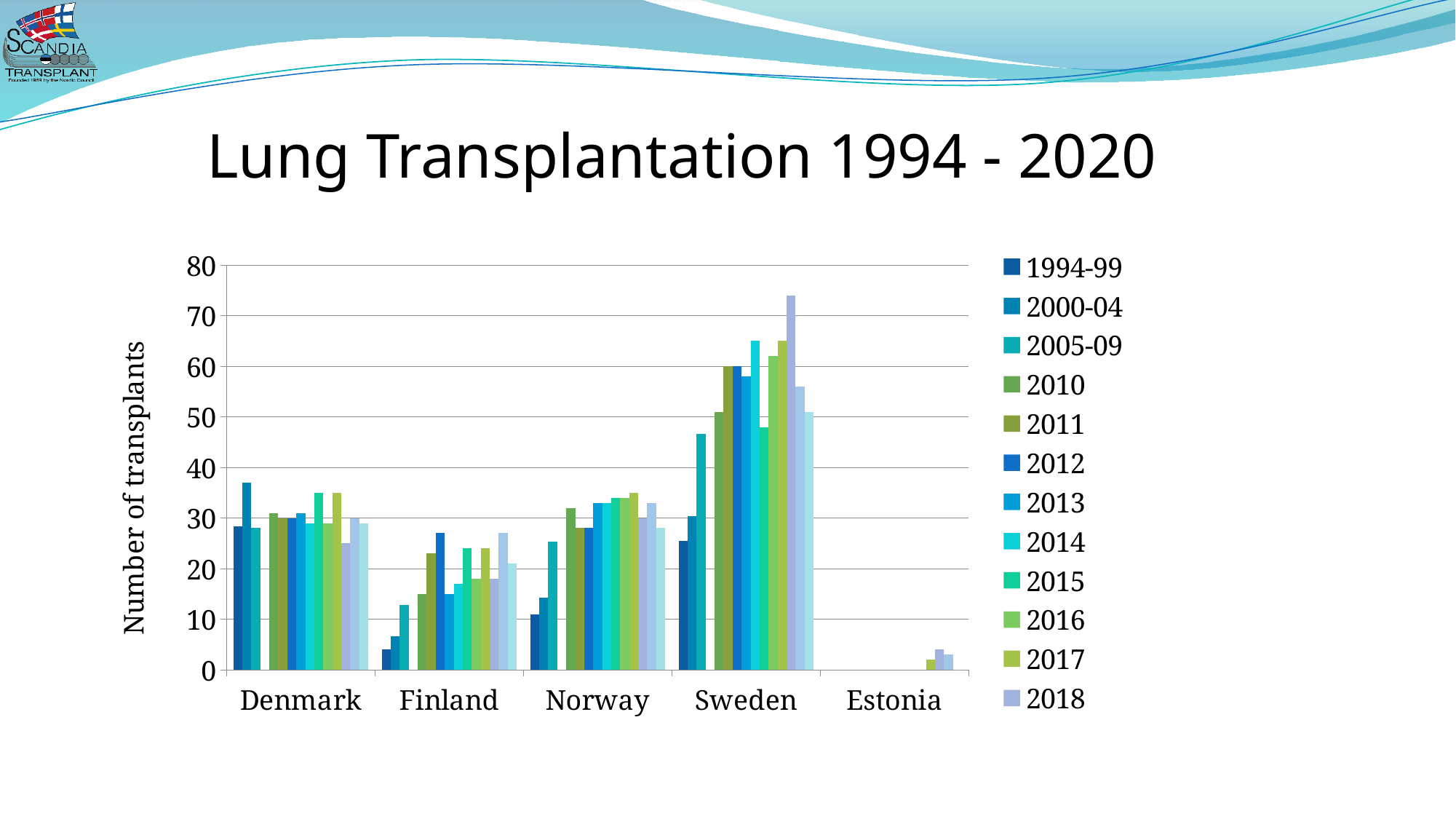
What is the title of the slide? Lung Transplantation 1994 - 2020 Is the value for Sweden in 2005-09 greater or less than 40? greater How many countries are shown on the x axis of the chart? 5 What kind of chart is shown on the slide? bar chart Is the value for Finland in 1994-99 greater or less than 10? less Which country has more lung transplants in 2018, Sweden or Norway? Sweden Is the value for Denmark in 2000-04 greater or less than 30? greater Which country has the highest number of lung transplants in the chart? Sweden Which country has the lowest number of lung transplants in the chart? Estonia What is the title of the chart's y axis? Number of transplants How many series does the chart's legend list? 12